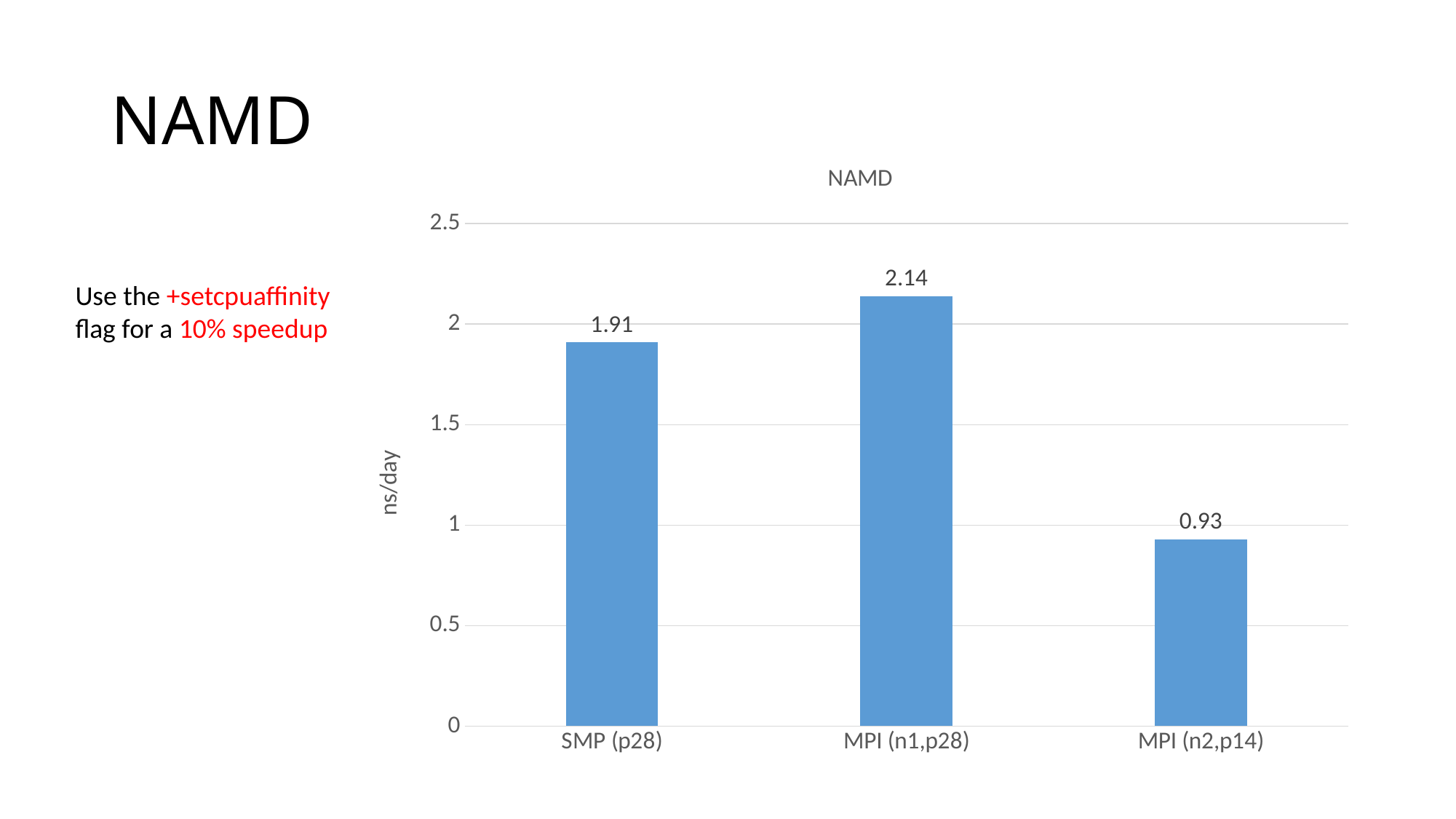
What is the difference between the values for MPI (n1,p28) and SMP (p28)? 0.23 Which category has the lowest value? MPI (n2,p14) What kind of chart is this? bar chart What is the difference between the values for SMP (p28) and MPI (n2,p14)? 0.98 Which category has the highest value? MPI (n1,p28) How many categories are shown on the x axis? 3 What is the value for SMP (p28)? 1.91 Which is larger, the value for SMP (p28) or the value for MPI (n2,p14)? SMP (p28) Is the value for MPI (n1,p28) greater or less than 2? greater What is the label of the y axis? ns/day What is the value for MPI (n1,p28)? 2.14 What is the value for MPI (n2,p14)? 0.93